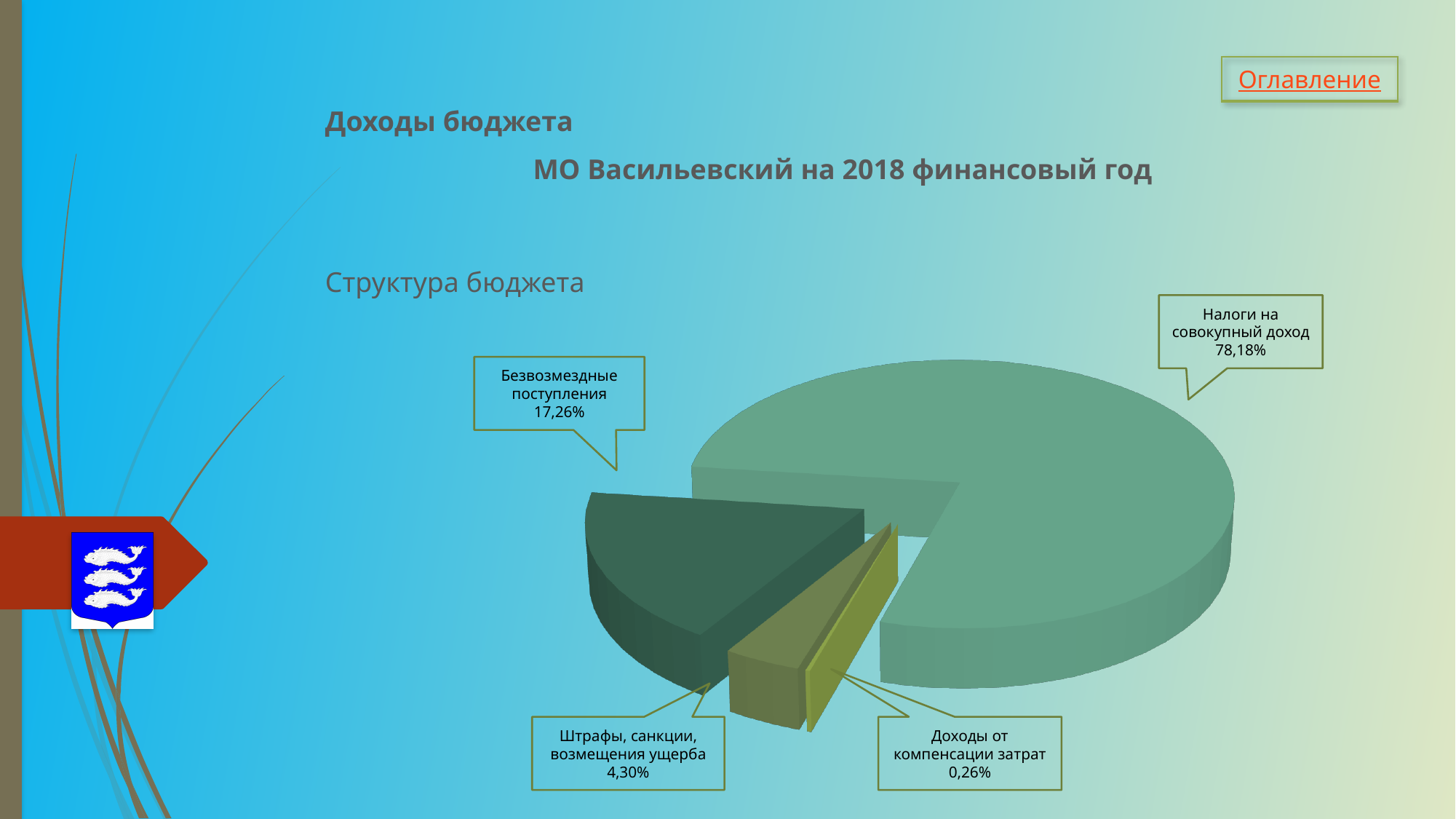
Which category has the largest slice of the pie? Налоги на совокупный доход Which category has the smallest slice of the pie? Доходы от компенсации затрат What share of the pie does "Налоги на совокупный доход" represent? 78,18% What is the value shown for "Штрафы, санкции, возмещения ущерба"? 4,30% What is the title of the chart section on the slide? Структура бюджета What is the value shown for "Доходы от компенсации затрат"? 0,26% Which is larger: the share of "Штрафы, санкции, возмещения ущерба" or the share of "Доходы от компенсации затрат"? Штрафы, санкции, возмещения ущерба What is the difference between the shares of "Безвозмездные поступления" and "Штрафы, санкции, возмещения ущерба"? 12,96% How many slices does the pie chart have? 4 What is the value shown for "Безвозмездные поступления"? 17,26% What is the difference between the shares of "Налоги на совокупный доход" and "Безвозмездные поступления"? 60,92% What kind of chart is shown on the slide? Pie chart